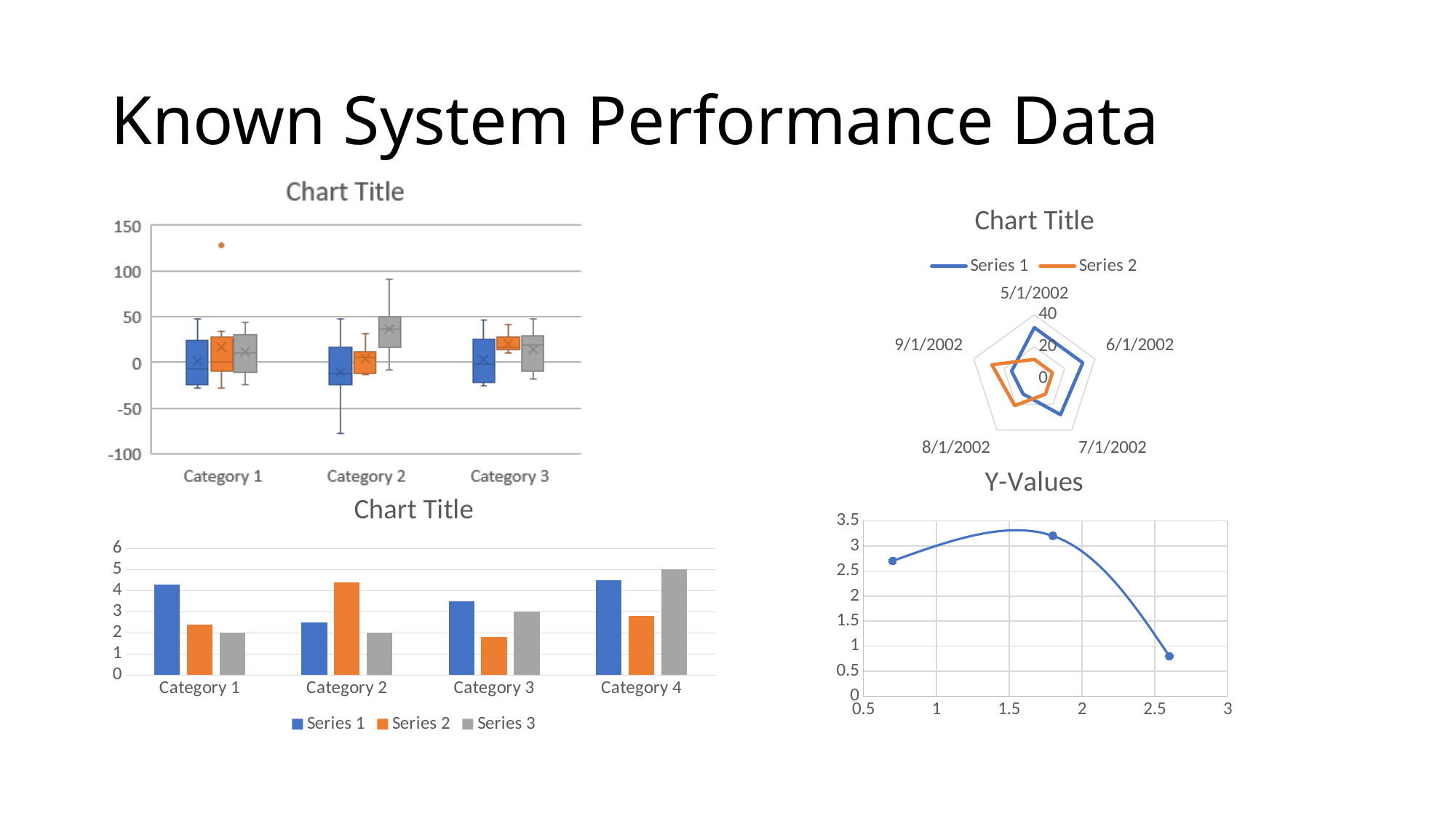
What kind of chart is the bottom-left chart with Category 1 to Category 4? bar chart In the bottom-right chart titled Y-Values, is the value of the point at x = 2.6 greater or less than 1? less In the bottom-left bar chart, is the Series 3 bar for Category 4 larger or smaller than the Series 2 bar for Category 4? larger In the bottom-left bar chart, which series has the shortest bar in Category 3? Series 2 How many series does the legend of the top-right radar chart list? 2 In the bottom-left bar chart, which series has the tallest bar in Category 2? Series 2 How many data points are plotted in the bottom-right chart titled Y-Values? 3 How many date categories are shown around the top-right radar chart? 5 What kind of chart is the top-right chart with the date labels 5/1/2002 to 9/1/2002? radar chart How many categories are shown on the x axis of the bottom-left bar chart? 4 How many series does the legend of the bottom-left bar chart list? 3 In the bottom-left bar chart, is the Series 1 bar for Category 1 greater or less than 4? greater